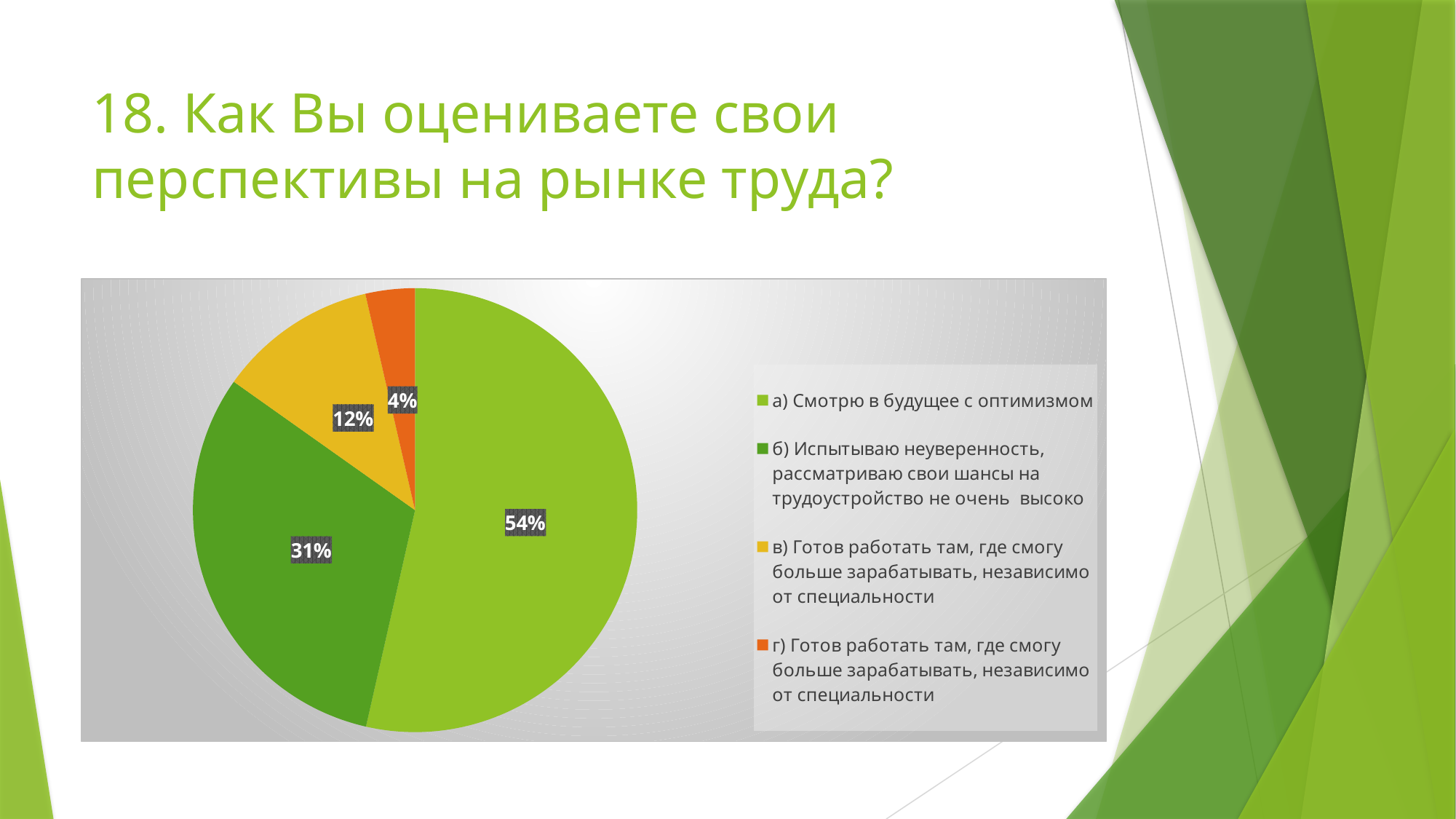
What is the difference in percentage points between option а) and option б)? 23 What is the combined share of options в) and г)? 16% What colour is the slice for option а) Смотрю в будущее с оптимизмом? Light green How many slices does the pie chart have? 4 What share of the pie does option а) Смотрю в будущее с оптимизмом take? 54% Which is larger: the share for option б) or the share for option в)? б) Which option has the smallest share of the pie? г) (the orange slice, 4%) What percentage is shown for option б) Испытываю неуверенность, рассматриваю свои шансы на трудоустройство не очень высоко? 31% What kind of chart is shown on the slide? Pie chart What percentage is shown for the yellow slice, option в)? 12% What percentage is shown for the orange slice, option г)? 4% Which option has the largest share of the pie? а) Смотрю в будущее с оптимизмом